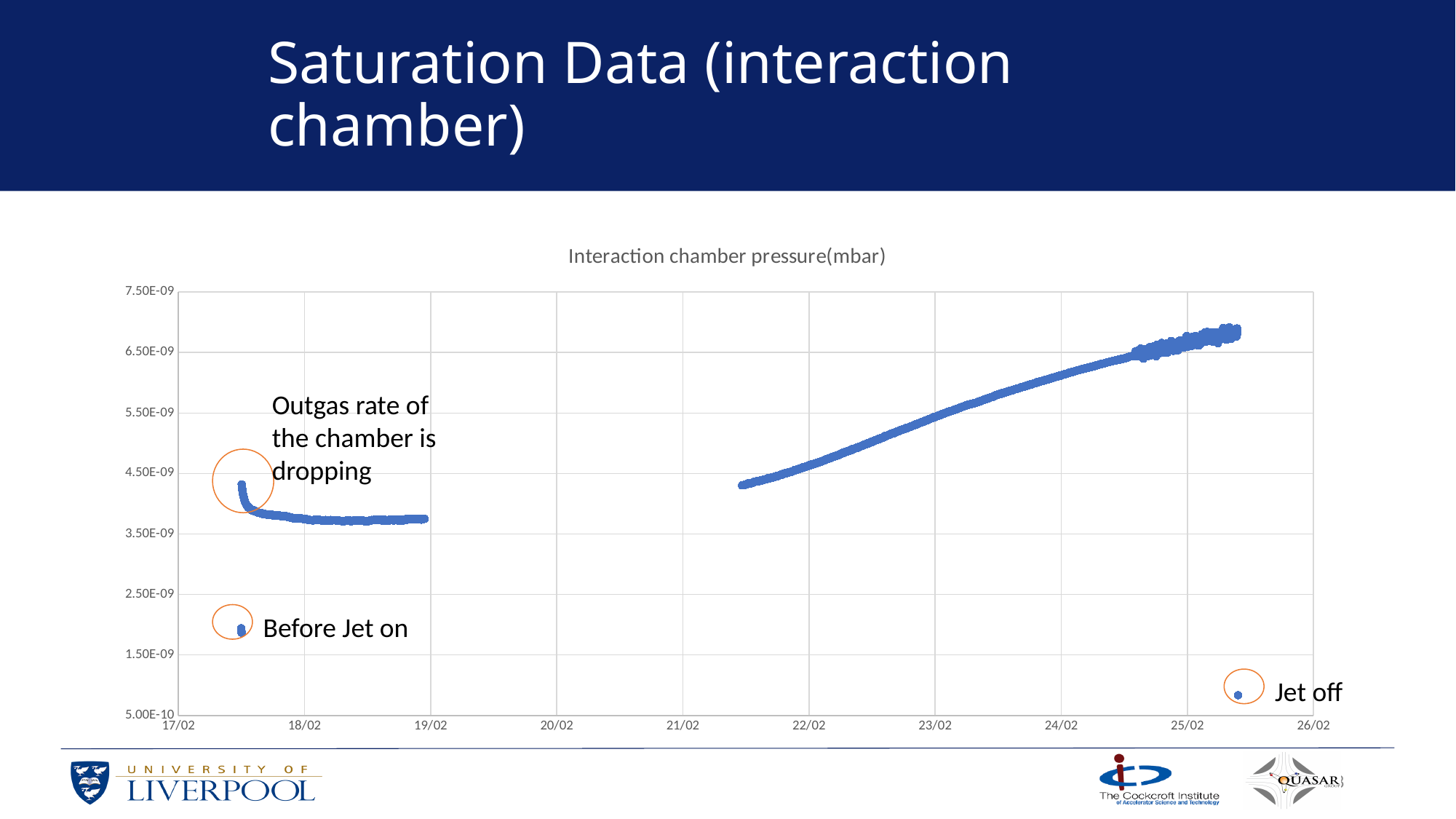
Is the pressure value at 25/02 greater or less than 6.50E-09? greater Is the pressure value at the point labelled "Jet off" greater or less than 1.50E-09? less Do the pressure values rise or fall between 17/02 and 18/02 after the jet is turned on? fall What is the highest value shown on the y axis? 7.50E-09 Is the pressure value at 23/02 greater or less than 4.50E-09? greater What is the first date shown on the x axis? 17/02 What kind of chart is shown on the slide? scatter chart Do the pressure values rise or fall between 22/02 and 25/02? rise What is the title of the chart? Interaction chamber pressure(mbar) Which is larger, the pressure at 18/02 or the pressure at 24/02? 24/02